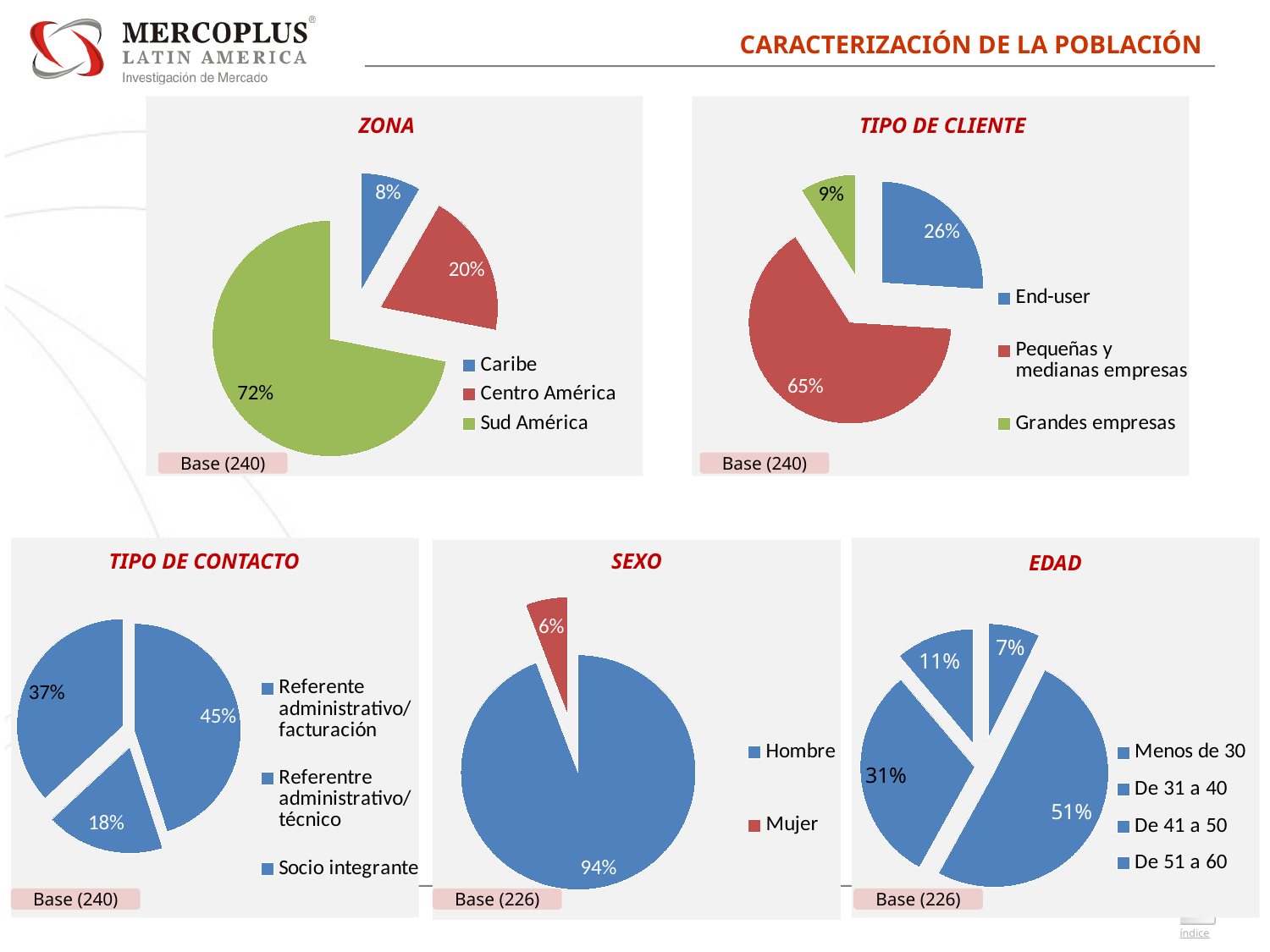
In the ZONA pie chart, what is the difference in percentage points between Sud América and Centro América? 52 What type of chart is used for SEXO? Pie chart How many categories does the legend of the EDAD pie chart list? 4 In the TIPO DE CLIENTE pie chart, which client type has the largest share? Pequeñas y medianas empresas In the TIPO DE CLIENTE pie chart, what percentage is shown for Pequeñas y medianas empresas? 65% In the ZONA pie chart, which zone has the smallest share? Caribe In the ZONA pie chart, what percentage is shown for Sud América? 72% In the SEXO pie chart, what percentage is shown for Hombre? 94% In the SEXO pie chart, what is the difference in percentage points between Hombre and Mujer? 88 In the TIPO DE CONTACTO pie chart, what is the largest percentage shown on any slice? 45% In the ZONA pie chart, what percentage is shown for Caribe? 8% In the TIPO DE CLIENTE pie chart, which is larger, End-user or Grandes empresas? End-user